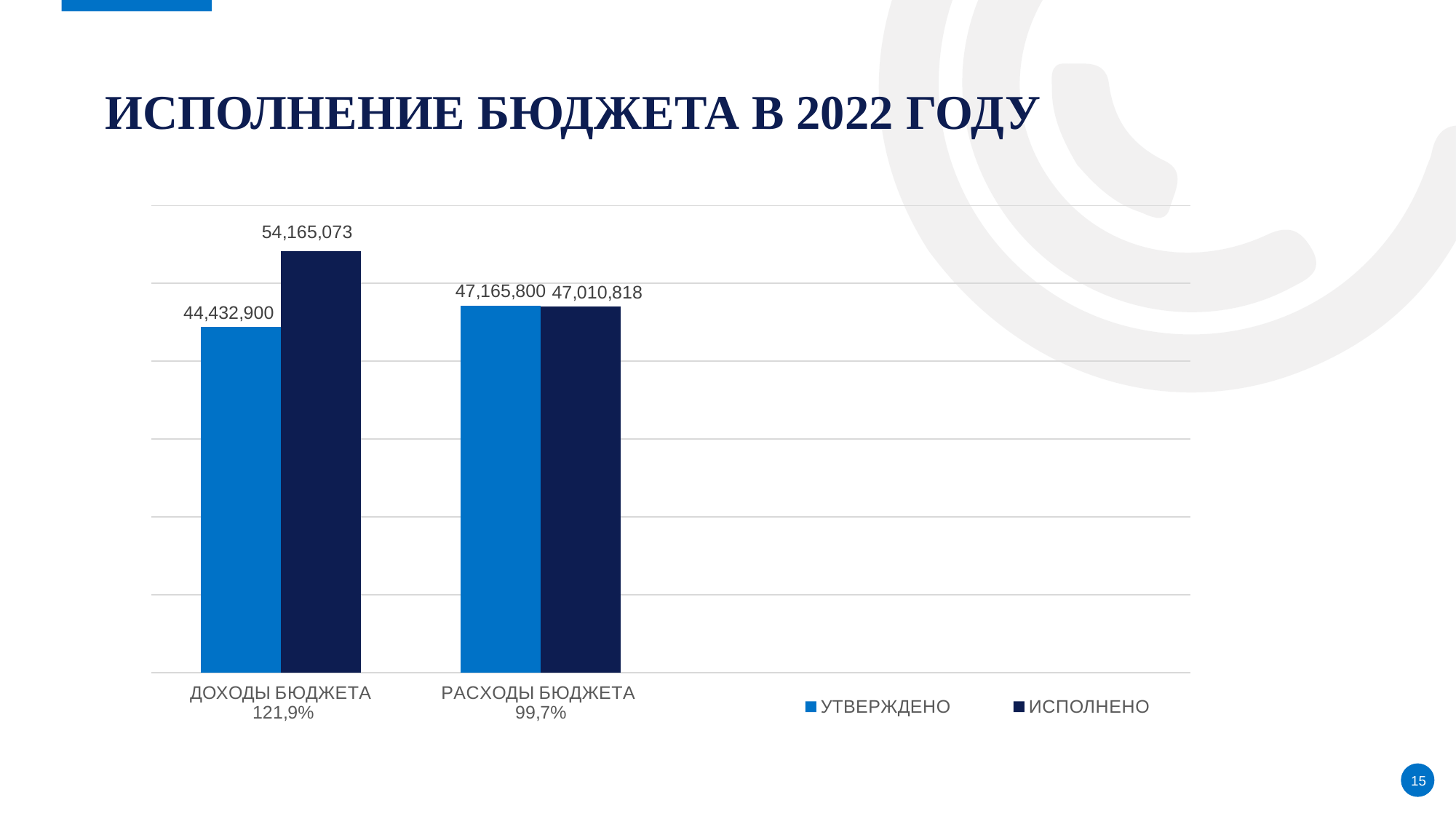
What is the УТВЕРЖДЕНО value for РАСХОДЫ БЮДЖЕТА? 47,165,800 How many categories are shown on the x axis? 2 What is the difference between the УТВЕРЖДЕНО and ИСПОЛНЕНО values for РАСХОДЫ БЮДЖЕТА? 154,982 What is the difference between the ИСПОЛНЕНО and УТВЕРЖДЕНО values for ДОХОДЫ БЮДЖЕТА? 9,732,173 What is the УТВЕРЖДЕНО value for ДОХОДЫ БЮДЖЕТА? 44,432,900 What is the ИСПОЛНЕНО value for РАСХОДЫ БЮДЖЕТА? 47,010,818 For ДОХОДЫ БЮДЖЕТА, which is larger: УТВЕРЖДЕНО or ИСПОЛНЕНО? ИСПОЛНЕНО Which bar has the highest value on the chart? ИСПОЛНЕНО for ДОХОДЫ БЮДЖЕТА Which bar has the lowest value on the chart? УТВЕРЖДЕНО for ДОХОДЫ БЮДЖЕТА What is the ИСПОЛНЕНО value for ДОХОДЫ БЮДЖЕТА? 54,165,073 What type of chart is shown on the slide? Bar chart How many series does the legend list? 2